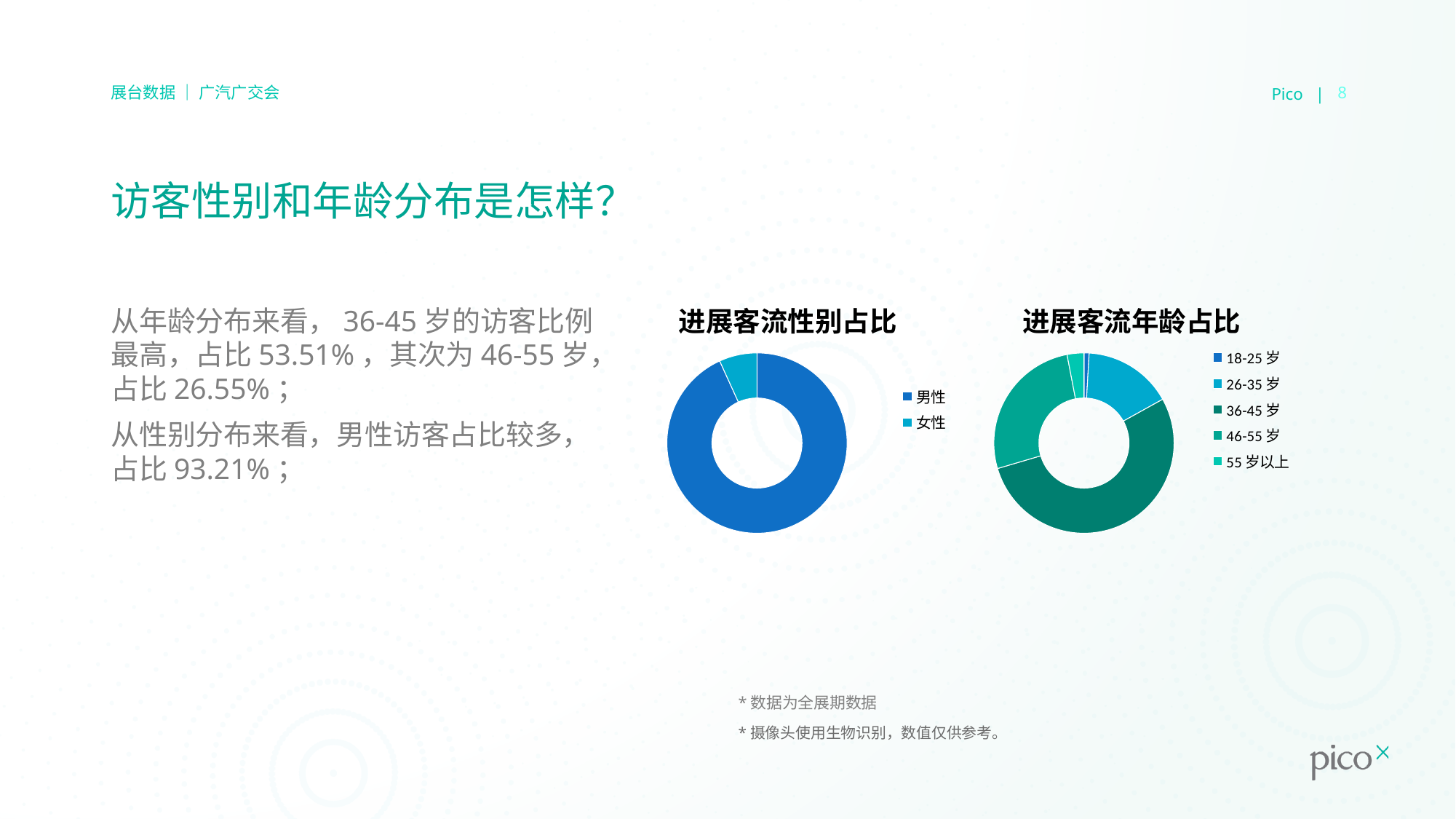
What kind of chart is the 进展客流性别占比 chart? Donut (pie) chart According to the slide, what share of visitors in the 进展客流年龄占比 chart are 46-55 岁? 26.55% How many categories does the legend of the 进展客流性别占比 chart list? 2 In the 进展客流性别占比 chart, which category has the largest share? 男性 What kind of chart is the 进展客流年龄占比 chart? Donut (pie) chart According to the slide, what share of visitors in the 进展客流年龄占比 chart are 36-45 岁? 53.51% In the 进展客流性别占比 chart, which category has the smallest share? 女性 In the 进展客流年龄占比 chart, which age group has the largest share? 36-45 岁 What is the title of the chart on the right side of the slide? 进展客流年龄占比 How many categories does the legend of the 进展客流年龄占比 chart list? 5 According to the slide, what share of visitors in the 进展客流性别占比 chart are 男性? 93.21% In the 进展客流年龄占比 chart, which is larger, the share for 46-55 岁 or the share for 26-35 岁? 46-55 岁